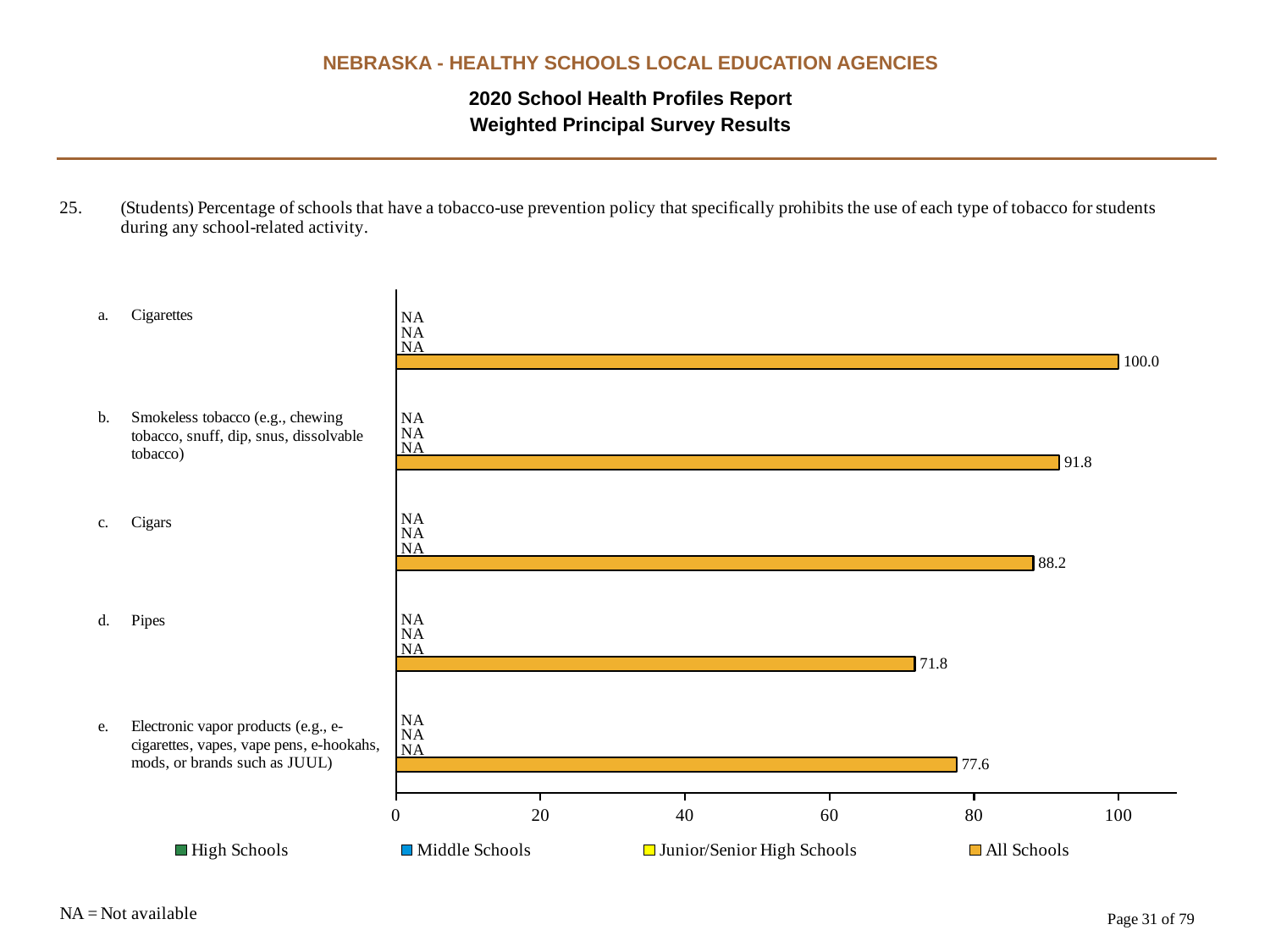
Which category has the lowest All Schools value? Pipes Which category has the highest All Schools value? Cigarettes What value is shown for High Schools for Cigarettes? NA Which is larger for All Schools: Cigars or Electronic vapor products? Cigars What is the All Schools value for Cigars? 88.2 How many series does the legend list? 4 What kind of chart is shown? Bar chart How many categories are shown in the chart? 5 What is the All Schools value for Electronic vapor products? 77.6 What is the All Schools value for Pipes? 71.8 What is the difference between the All Schools values for Cigarettes and Smokeless tobacco? 8.2 What is the All Schools value for Cigarettes? 100.0